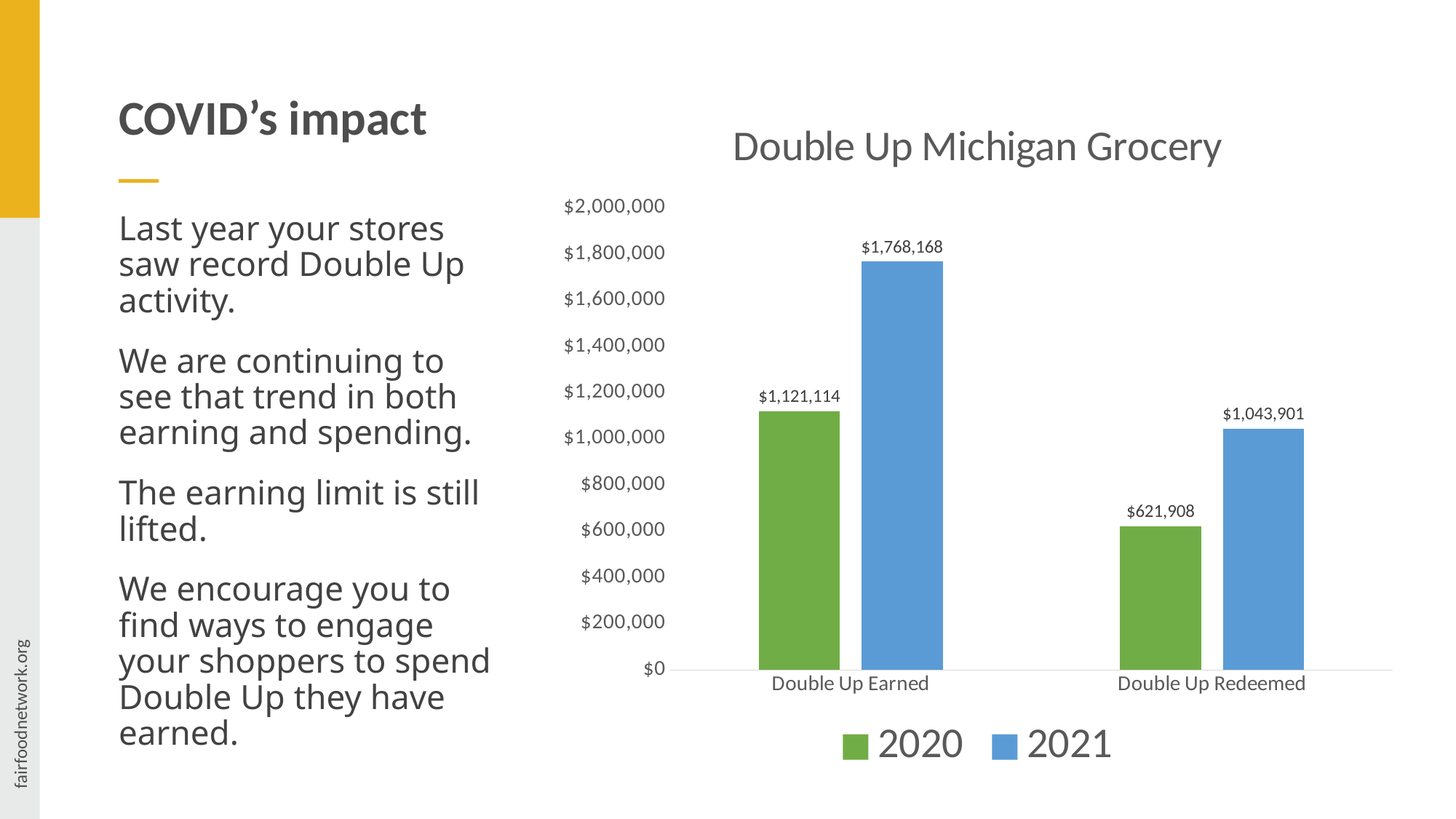
What is the value for Double Up Redeemed in 2021? $1,043,901 Which bar has the highest value on the chart? Double Up Earned, 2021 How many series does the legend list? 2 What is the difference between the 2021 and 2020 values for Double Up Redeemed? $421,993 What is the value for Double Up Earned in 2020? $1,121,114 Which is larger: Double Up Earned in 2020 or Double Up Redeemed in 2021? Double Up Earned in 2020 What is the value for Double Up Redeemed in 2020? $621,908 What is the title of the chart? Double Up Michigan Grocery What is the value for Double Up Earned in 2021? $1,768,168 Which bar has the lowest value on the chart? Double Up Redeemed, 2020 What is the difference between the 2021 and 2020 values for Double Up Earned? $647,054 What kind of chart is shown on the slide? Bar chart